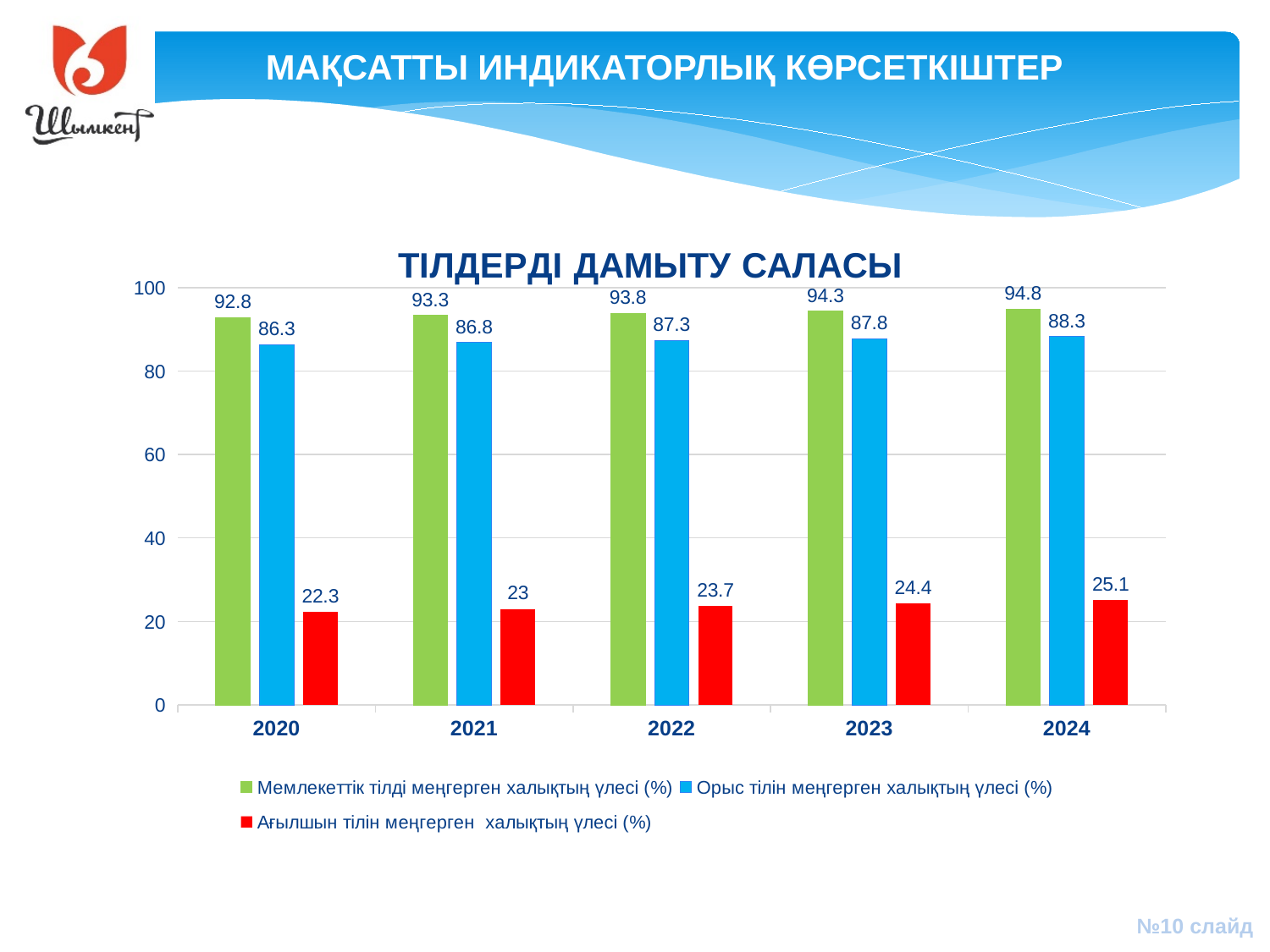
In which year is the value for 'Ағылшын тілін меңгерген халықтың үлесі (%)' lowest? 2020 Which is larger in 2021: the value for 'Орыс тілін меңгерген халықтың үлесі (%)' or the value for 'Ағылшын тілін меңгерген халықтың үлесі (%)'? Орыс тілін меңгерген халықтың үлесі (%) Is the value for 'Ағылшын тілін меңгерген халықтың үлесі (%)' in 2023 greater or less than 40? less What kind of chart is shown on the slide? bar chart In which year is the value for 'Мемлекеттік тілді меңгерген халықтың үлесі (%)' highest? 2024 How many years are shown on the x axis? 5 What is the difference between the 'Мемлекеттік тілді меңгерген халықтың үлесі (%)' value and the 'Орыс тілін меңгерген халықтың үлесі (%)' value in 2023? 6.5 What is the value for 'Орыс тілін меңгерген халықтың үлесі (%)' in 2020? 86.3 What is the value for 'Мемлекеттік тілді меңгерген халықтың үлесі (%)' in 2022? 93.8 Do the values for 'Орыс тілін меңгерген халықтың үлесі (%)' rise or fall from 2020 to 2024? rise How many series does the legend list? 3 What is the value for 'Ағылшын тілін меңгерген халықтың үлесі (%)' in 2024? 25.1